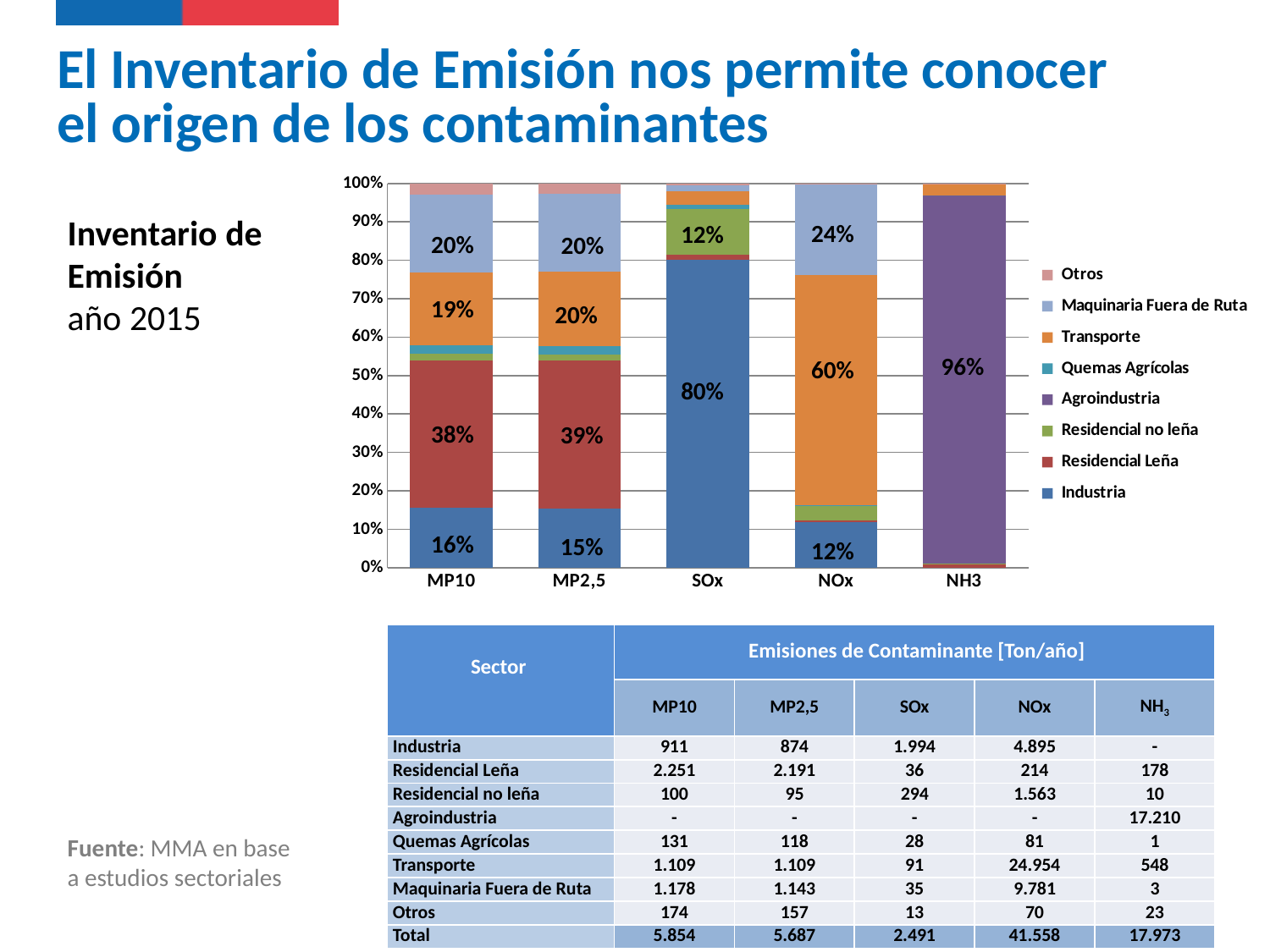
What share of NOx emissions comes from Transporte? 60% What share of SOx emissions comes from Industria? 80% Which sector has the largest share of NOx emissions? Transporte What share of MP2,5 emissions comes from Industria? 15% How many series does the chart legend list? 8 Which is larger: the Transporte share for MP10 or the Maquinaria Fuera de Ruta share for MP10? Maquinaria Fuera de Ruta Which sector has the largest share of SOx emissions? Industria What kind of chart is shown on the slide? Stacked bar chart What is the difference between the Residencial Leña share for MP2,5 and the Industria share for MP2,5? 24% What share of MP10 emissions comes from Residencial Leña? 38% What share of NH3 emissions comes from Agroindustria? 96% How many pollutant categories are shown on the x axis of the chart? 5